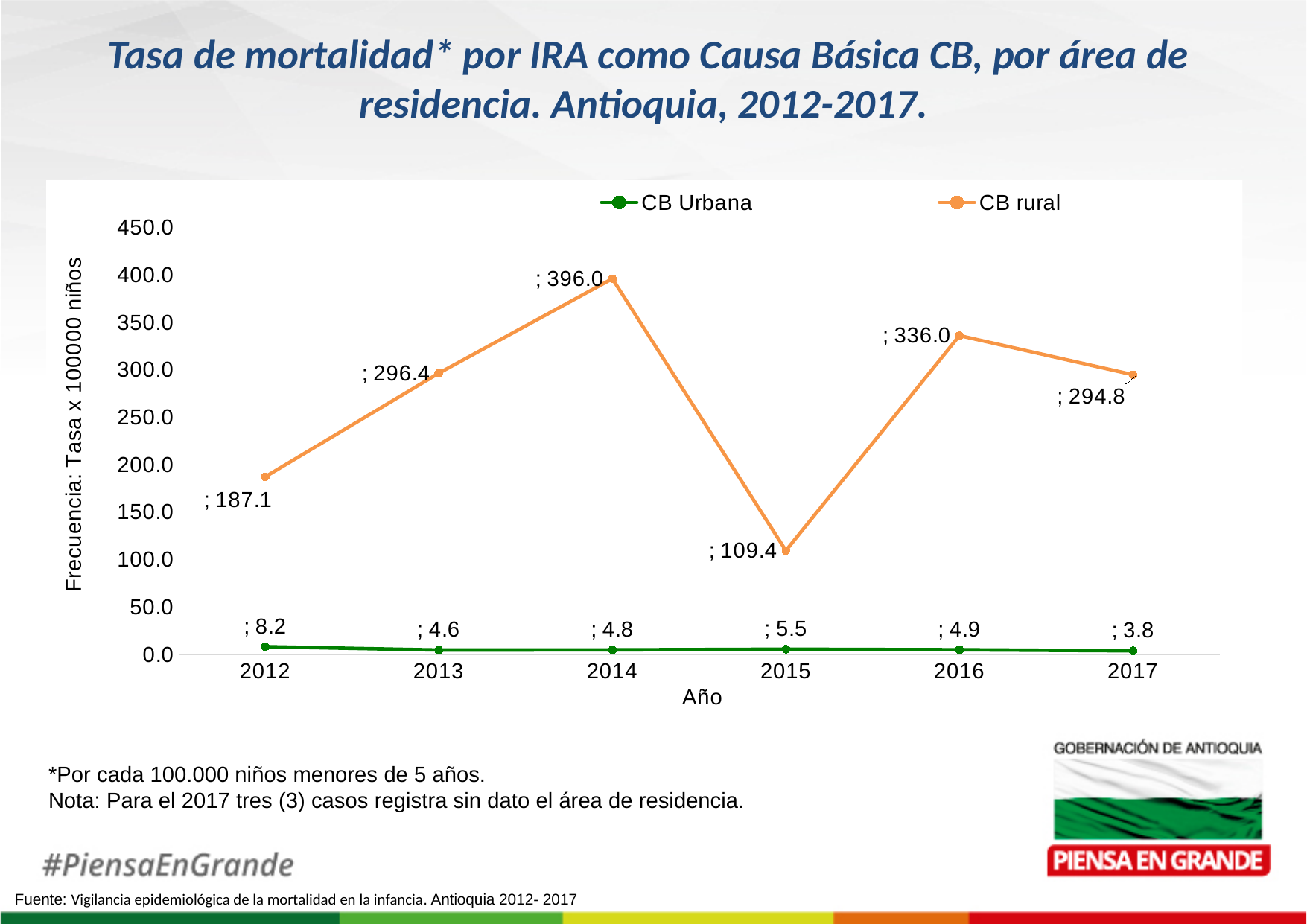
What is the difference between the CB rural values for 2016 and 2017? 41.2 How many series does the legend list? 2 What kind of chart is shown on the slide? line chart What is the CB Urbana value for 2012? 8.2 How many years are shown on the x axis? 6 In which year is the CB rural value highest? 2014 What is the CB rural value for 2014? 396.0 Is the CB rural value for 2012 greater or less than 200.0? less What is the CB rural value for 2015? 109.4 In which year is the CB rural value lowest? 2015 Which is larger, the CB rural value for 2013 or for 2017? 2013 In which year is the CB Urbana value lowest? 2017